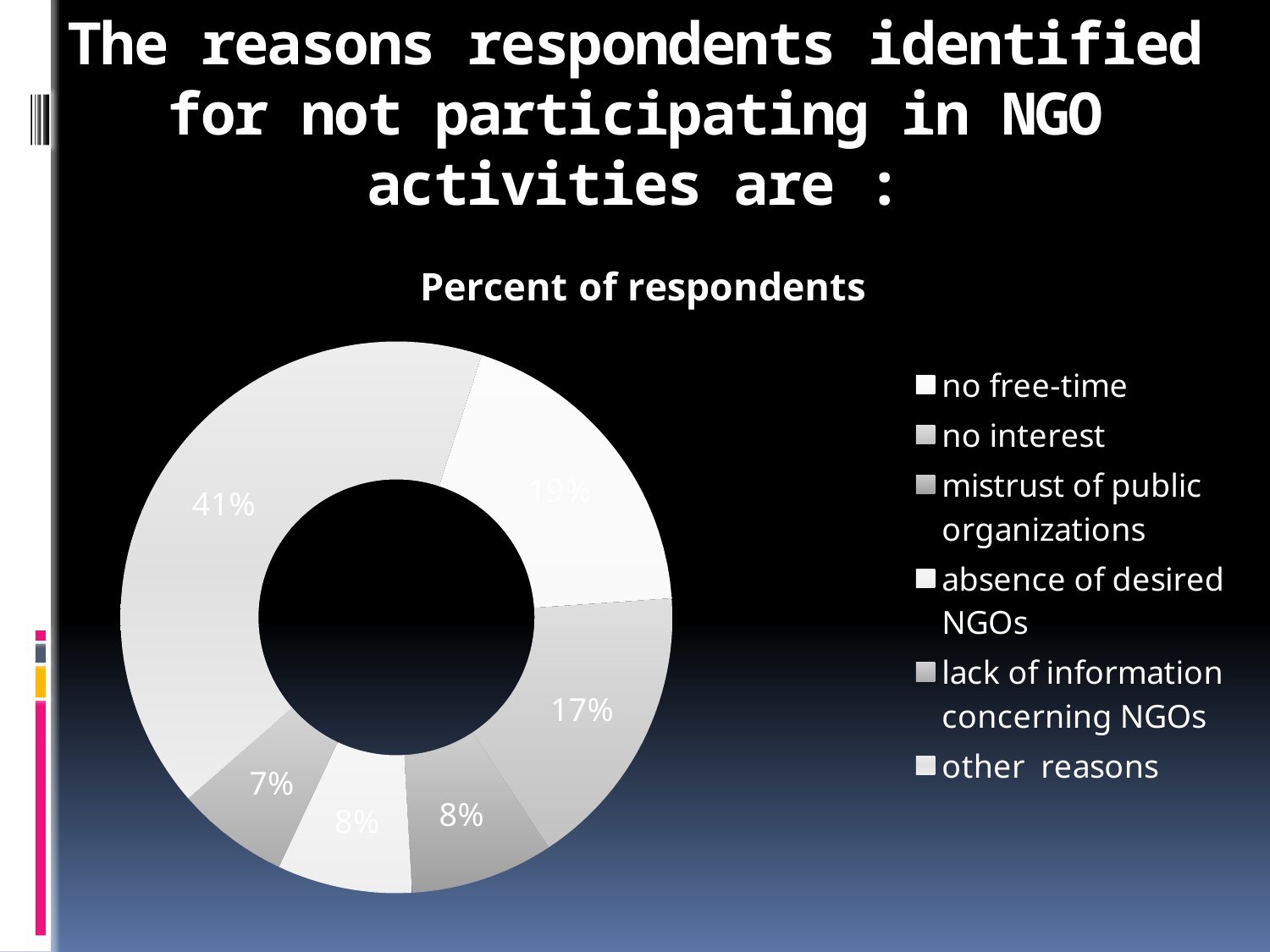
What percentage of respondents cited 'lack of information concerning NGOs'? 7% What is the smallest percentage shown on the chart? 7% What percentage of respondents cited 'no free-time'? 19% How many categories does the chart's legend list? 6 What is the combined share of the three smallest slices (8%, 8% and 7%)? 23% What is the largest percentage shown on the chart? 41% What is the difference in percentage points between the largest slice (41%) and the 19% slice? 22 percentage points What percentage of respondents cited 'other reasons'? 41% Which is larger: the share for 'no free-time' or the share for 'no interest'? no free-time What kind of chart is shown on the slide? doughnut (pie) chart What percentage of respondents cited 'no interest'? 17% What is the title of the chart? Percent of respondents